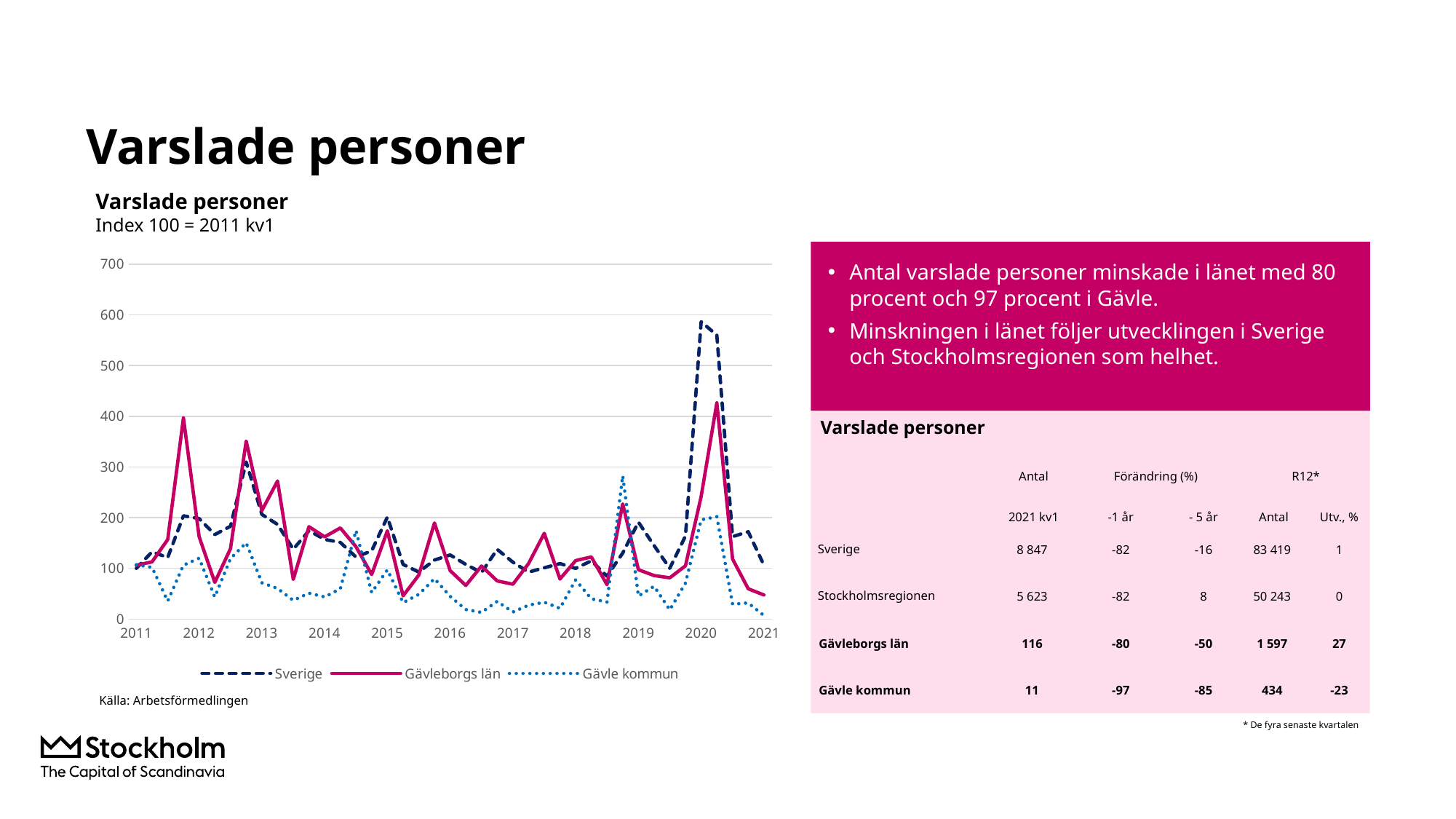
At the 2020 peak, which series is larger: Sverige or Gävle kommun? Sverige How many year labels are shown on the x axis? 11 Is the value for Gävle kommun at the end of 2021 greater or less than 100? less Which series reaches the highest value anywhere on the chart? Sverige Which series are listed in the chart legend? Sverige, Gävleborgs län, Gävle kommun How many series does the chart legend list? 3 Is the peak value for Gävleborgs län in late 2011 greater or less than 300? greater What kind of chart is shown on the slide? line chart Is the peak value for Gävle kommun in 2020 greater or less than 300? less What is the subtitle under the chart title 'Varslade personer'? Index 100 = 2011 kv1